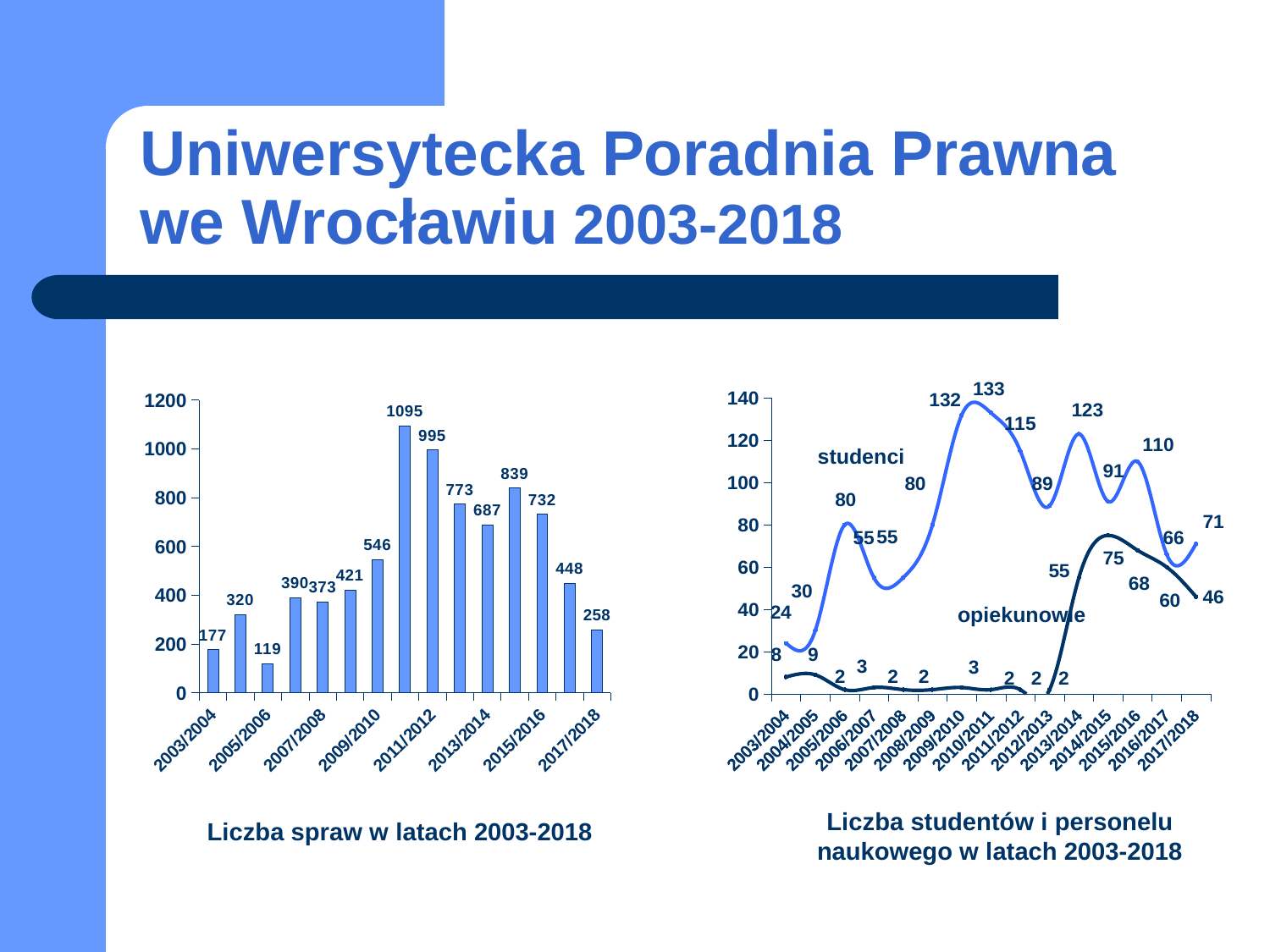
What type of chart is the left chart, 'Liczba spraw w latach 2003-2018'? bar chart In the right chart 'Liczba studentów i personelu naukowego w latach 2003-2018', which is larger in 2017/2018: studenci or opiekunowie? studenci In the left chart 'Liczba spraw w latach 2003-2018', how many bars are there? 15 In the right chart 'Liczba studentów i personelu naukowego w latach 2003-2018', which year has the highest value for studenci? 2010/2011 In the right chart 'Liczba studentów i personelu naukowego w latach 2003-2018', what is the value for opiekunowie in 2014/2015? 75 In the right chart 'Liczba studentów i personelu naukowego w latach 2003-2018', how many series are plotted? 2 In the left chart 'Liczba spraw w latach 2003-2018', what is the value for 2005/2006? 119 In the left chart 'Liczba spraw w latach 2003-2018', what is the value for 2011/2012? 995 In the left chart 'Liczba spraw w latach 2003-2018', which year has the lowest value? 2005/2006 In the left chart 'Liczba spraw w latach 2003-2018', what is the difference between the values for 2013/2014 and 2017/2018? 429 In the right chart 'Liczba studentów i personelu naukowego w latach 2003-2018', what is the value for studenci in 2010/2011? 133 In the left chart 'Liczba spraw w latach 2003-2018', what is the highest value shown? 1095